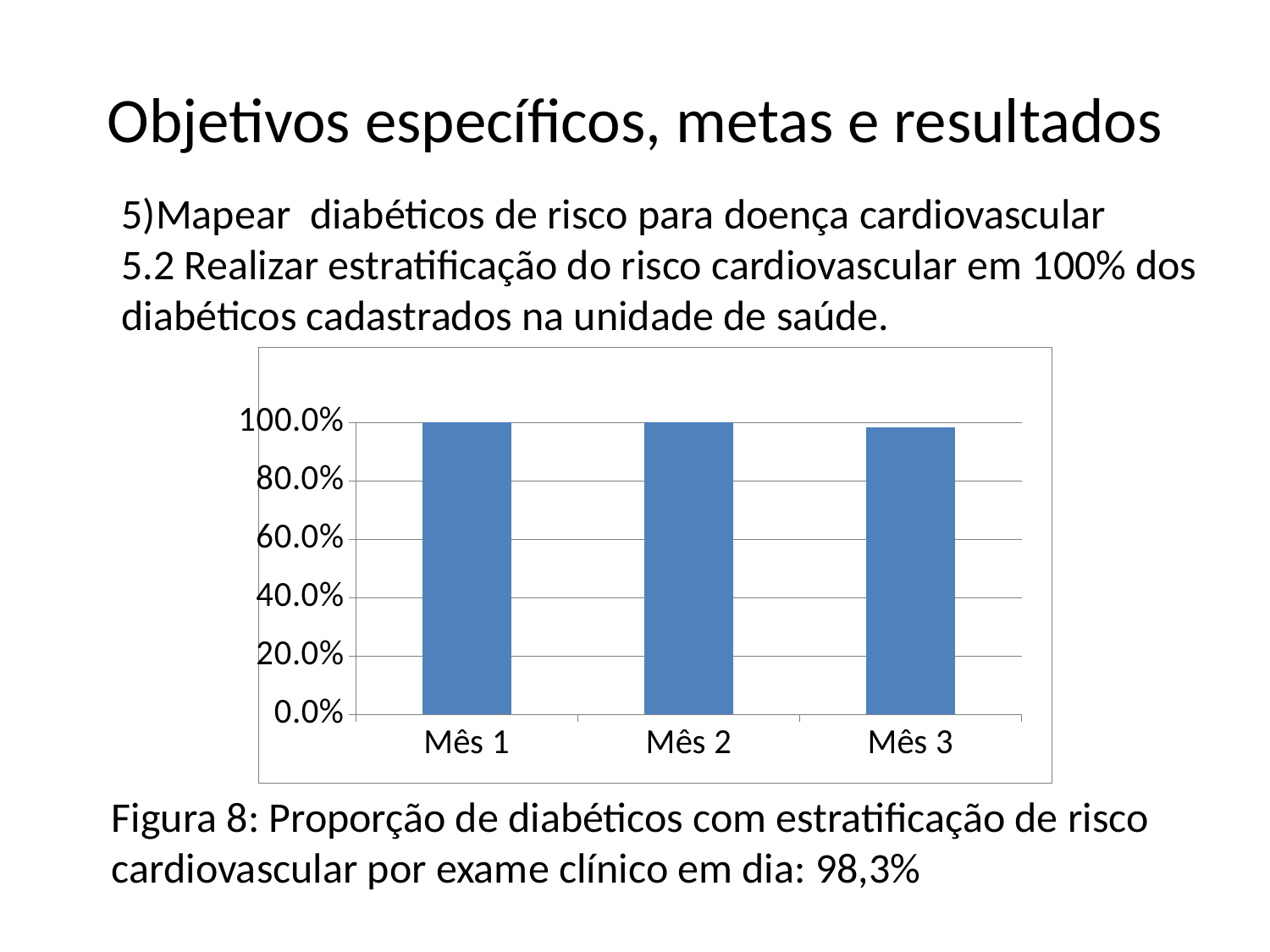
What is the highest tick value shown on the y axis? 100.0% How many categories are shown on the x axis? 3 What is the value for Mês 2? 100.0% Is the value for Mês 3 greater or less than 80.0%? greater What is the value for Mês 1? 100.0% What kind of chart is shown on the slide? bar chart Is the value for Mês 1 greater or less than 60.0%? greater What are the category labels on the x axis? Mês 1, Mês 2, Mês 3 Which month has the lowest value? Mês 3